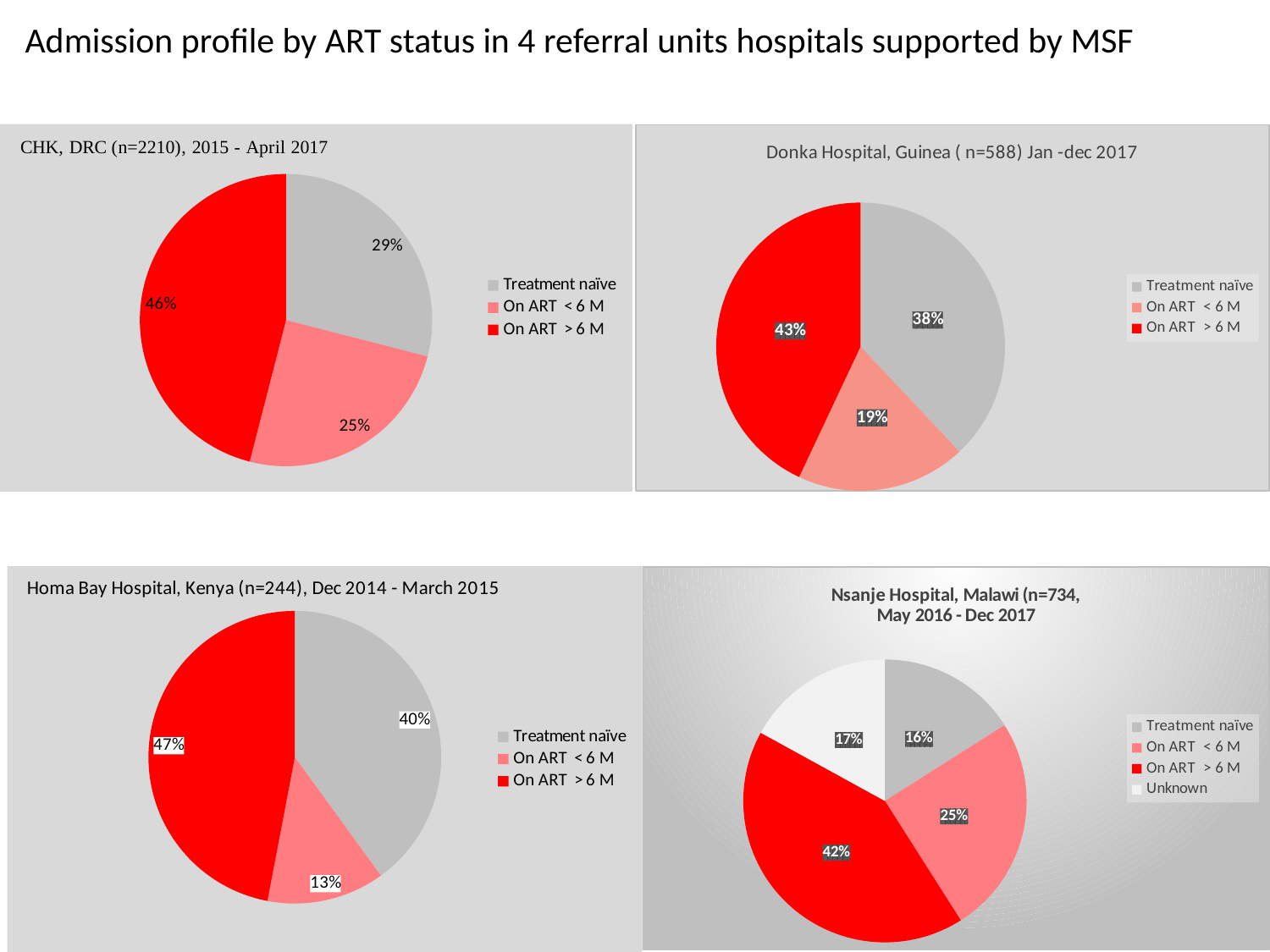
In the Nsanje Hospital, Malawi chart, what share of admissions were Unknown? 17% How many charts are shown on the slide? 4 What is the sample size (n) shown in the title of the Donka Hospital, Guinea chart? 588 In the Donka Hospital, Guinea chart, what share of admissions were Treatment naïve? 38% In the Homa Bay Hospital, Kenya chart, what share of admissions were On ART < 6 M? 13% In the CHK, DRC chart, which is larger: the Treatment naïve share or the On ART < 6 M share? Treatment naïve In the Donka Hospital, Guinea chart, what is the difference between the On ART > 6 M share and the On ART < 6 M share? 24% How many categories does the legend of the Nsanje Hospital, Malawi chart list? 4 In the Homa Bay Hospital, Kenya chart, which category has the smallest slice? On ART < 6 M What type of chart is the Homa Bay Hospital, Kenya chart? Pie chart In the CHK, DRC chart, what share of admissions were On ART > 6 M? 46% In the Nsanje Hospital, Malawi chart, which category has the largest slice? On ART > 6 M